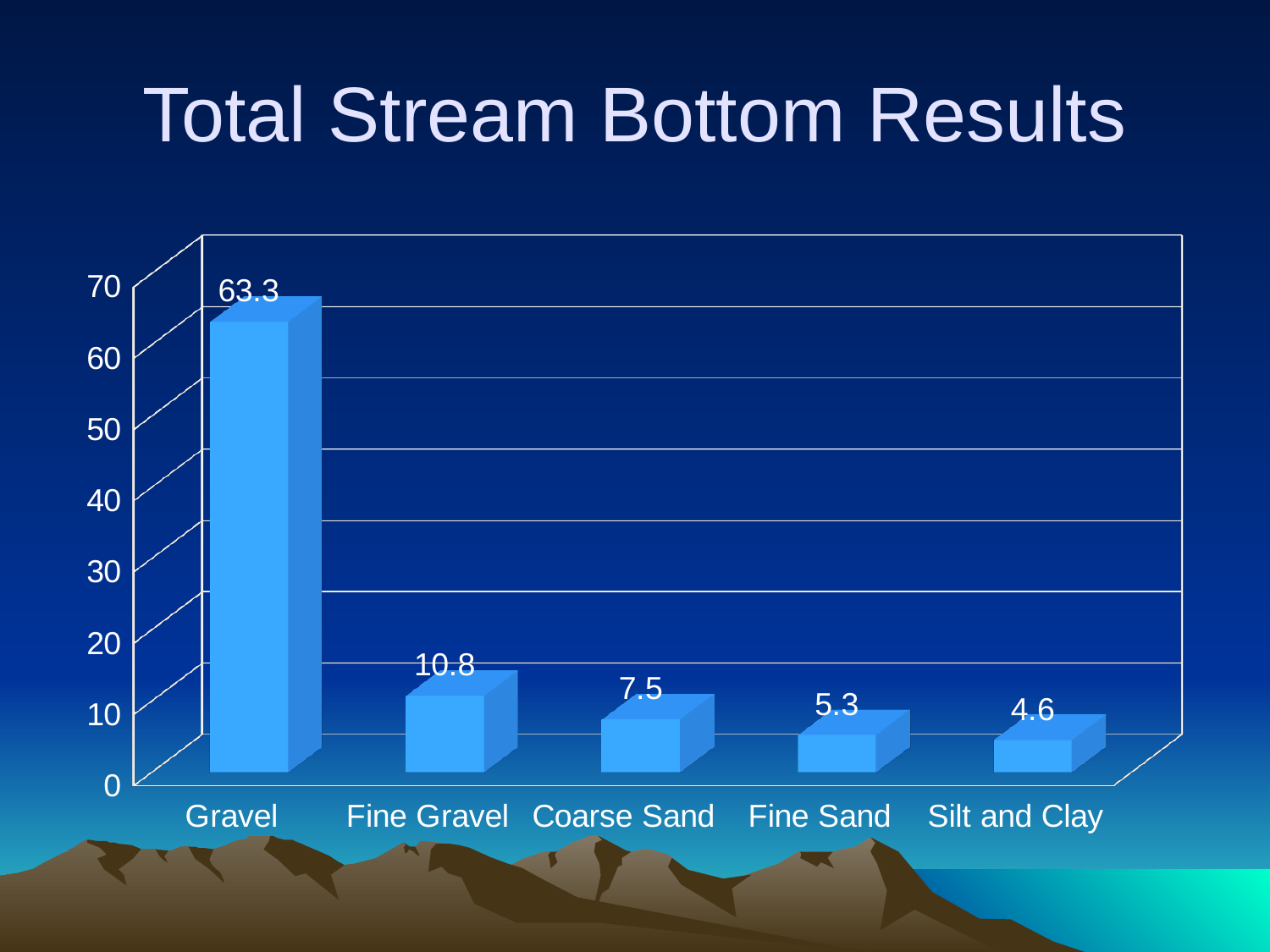
What is the difference between the values for Fine Sand and Silt and Clay? 0.7 What is the value for Fine Gravel? 10.8 Which category has the lowest value? Silt and Clay How many categories are shown on the x axis? 5 What is the value for Gravel? 63.3 What is the value for Coarse Sand? 7.5 Which is larger, the value for Coarse Sand or the value for Fine Sand? Coarse Sand Which category has the highest value? Gravel Do the values rise or fall from left to right along the x axis? fall What kind of chart is shown on the slide? bar chart What is the difference between the values for Gravel and Fine Gravel? 52.5 What is the value for Silt and Clay? 4.6